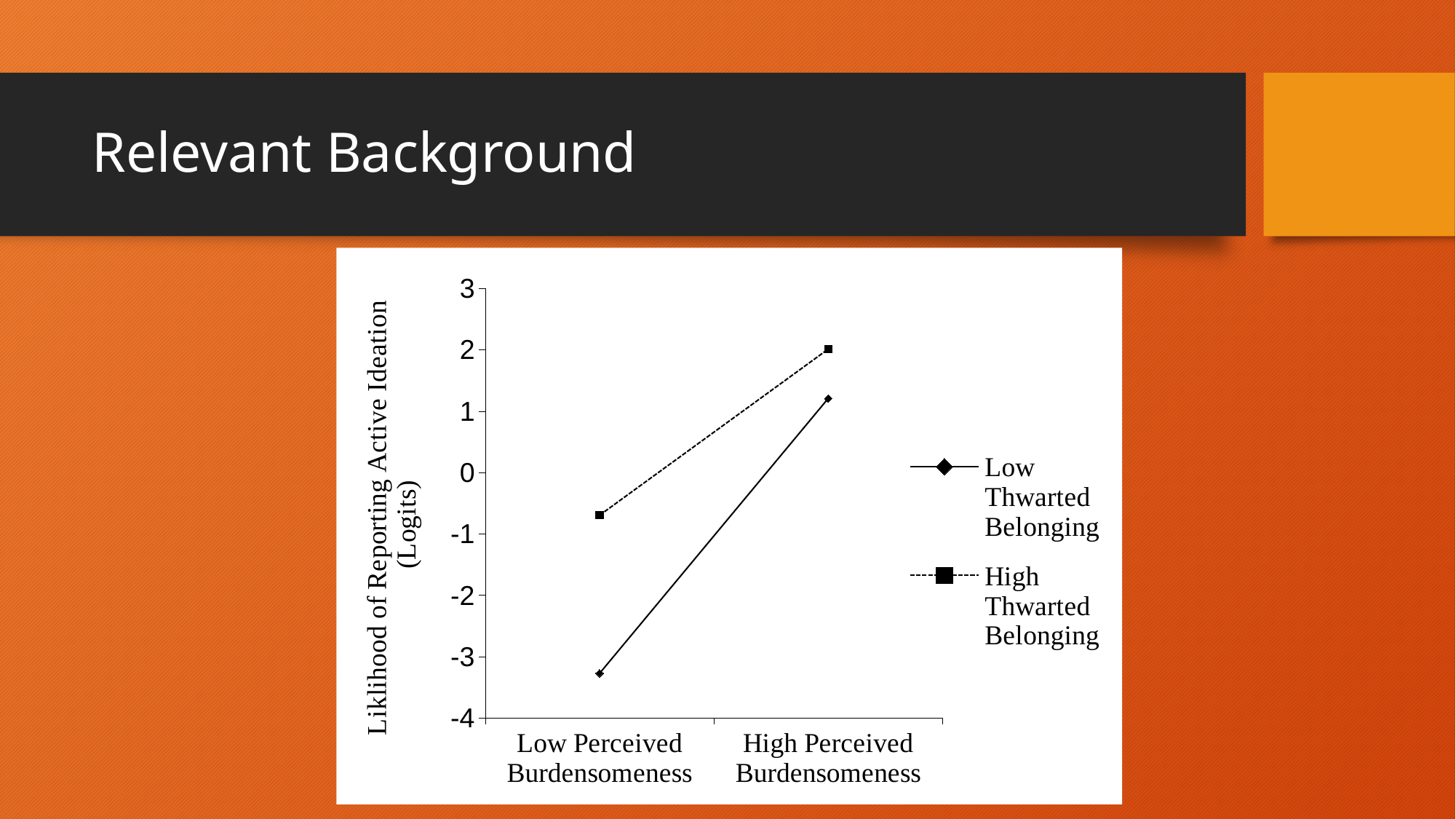
How many categories are shown on the x axis? 2 At Low Perceived Burdensomeness, which series has the higher value, Low Thwarted Belonging or High Thwarted Belonging? High Thwarted Belonging Does the Low Thwarted Belonging line rise or fall from Low Perceived Burdensomeness to High Perceived Burdensomeness? rise At High Perceived Burdensomeness, which series has the lower value, Low Thwarted Belonging or High Thwarted Belonging? Low Thwarted Belonging Is the High Thwarted Belonging value at High Perceived Burdensomeness greater or less than 1? greater Is the Low Thwarted Belonging value at High Perceived Burdensomeness greater or less than 1? greater How many series does the legend list? 2 What kind of chart is shown on the slide? line chart What is the label of the y axis? Liklihood of Reporting Active Ideation (Logits) Is the Low Thwarted Belonging value at Low Perceived Burdensomeness greater or less than -3? less Does the High Thwarted Belonging line rise or fall from Low Perceived Burdensomeness to High Perceived Burdensomeness? rise